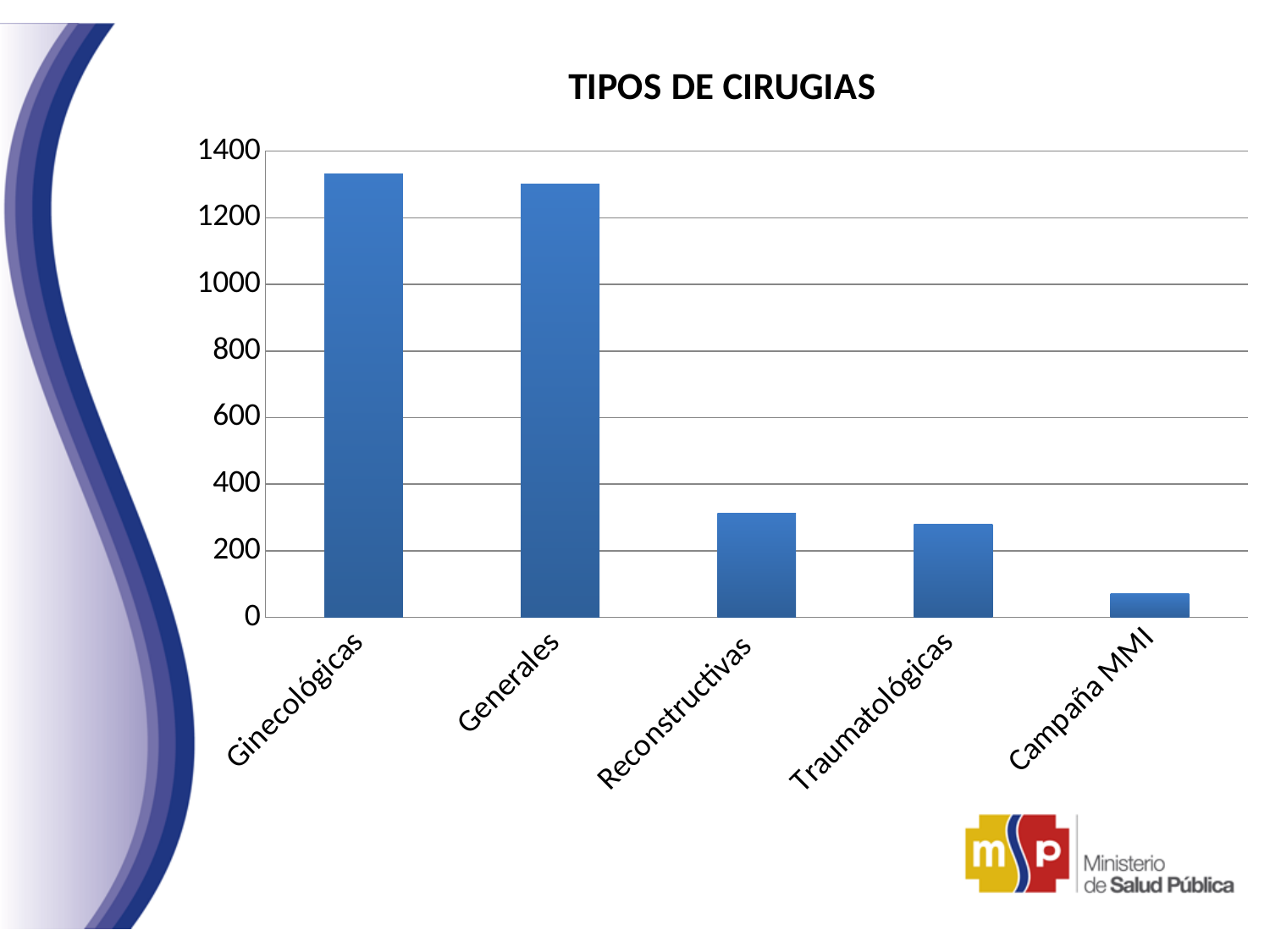
What is the title of the chart? TIPOS DE CIRUGIAS Is the value for Ginecológicas greater or less than 1200? greater Do the values generally rise or fall moving from left to right along the x axis? fall Is the value for Generales greater or less than 1200? greater Which category has the lowest value in the chart? Campaña MMI What kind of chart is shown on the slide? bar chart Which is larger, the value for Generales or the value for Reconstructivas? Generales Is the value for Traumatológicas greater or less than 200? greater How many categories are shown on the x axis of the chart? 5 Which is larger, the value for Traumatológicas or the value for Campaña MMI? Traumatológicas